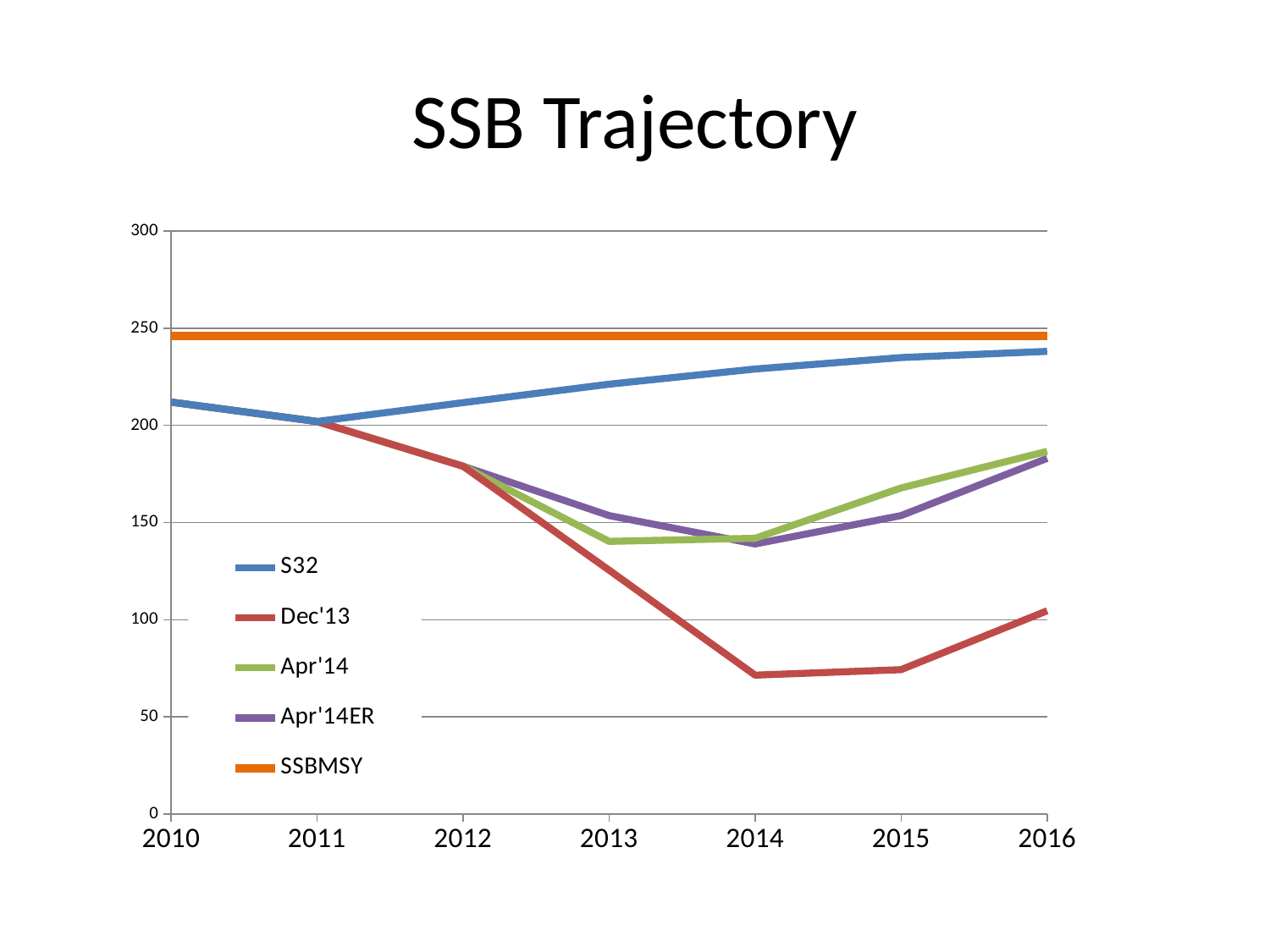
Does the S32 series rise or fall from 2011 to 2016? rise Is the value for Apr'14 in 2013 greater or less than 150? less How many series does the legend list? 5 In 2013, which is larger, Apr'14ER or Apr'14? Apr'14ER How many years are shown along the x axis? 7 What kind of chart is shown on the slide? line chart Is the SSBMSY line greater or less than 200? greater What is the title of the chart? SSB Trajectory Is the value for Dec'13 in 2014 greater or less than 100? less In 2016, which is larger, S32 or Dec'13? S32 Which series has the lowest value in 2014? Dec'13